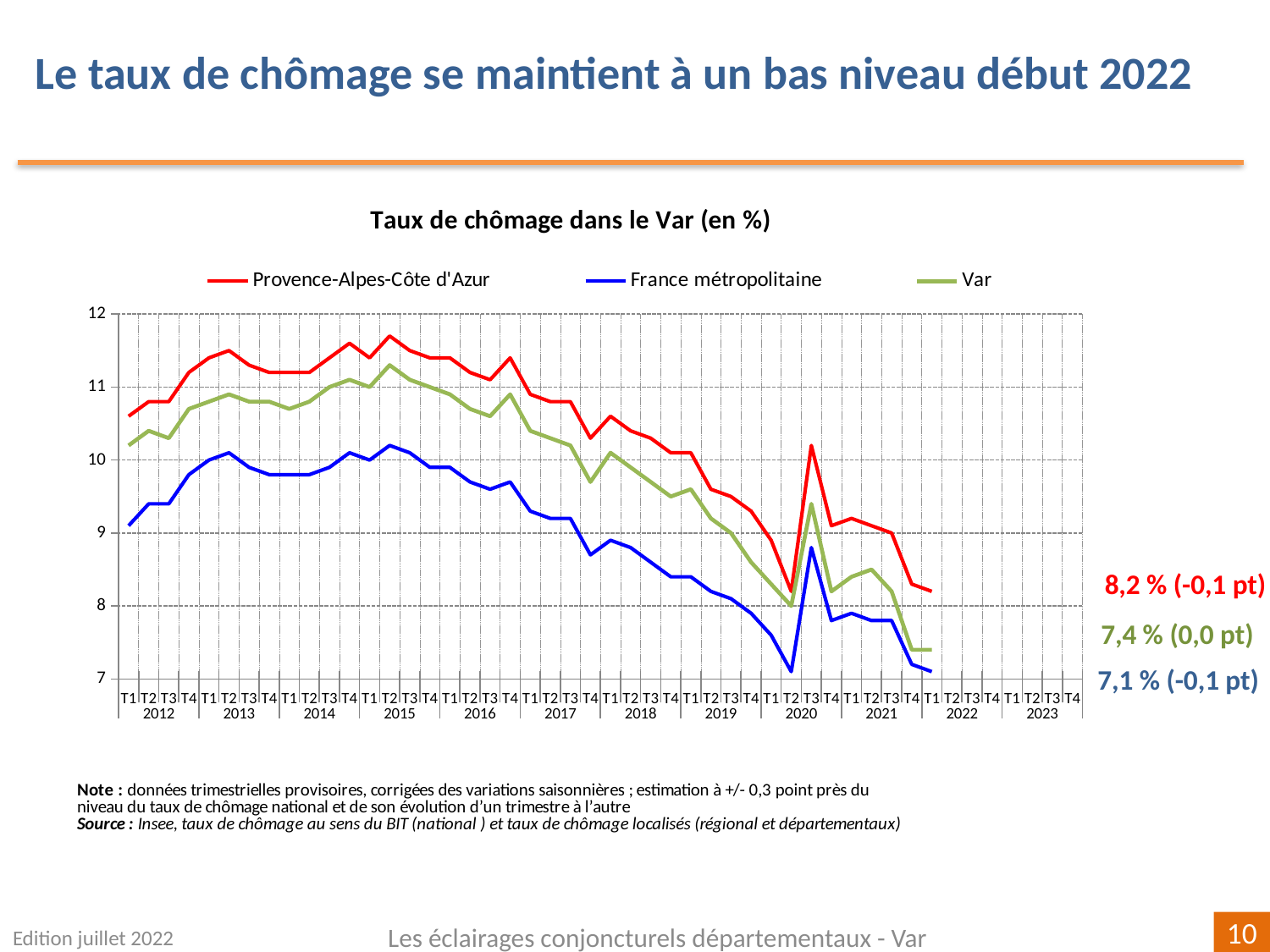
What is the latest unemployment rate shown for Provence-Alpes-Côte d'Azur? 8,2 % What is the title of the chart? Taux de chômage dans le Var (en %) What is the difference between the latest values for Provence-Alpes-Côte d'Azur and Var? 0,8 points Which series is higher at T1 2022, Provence-Alpes-Côte d'Azur or France métropolitaine? Provence-Alpes-Côte d'Azur Do the unemployment rates generally rise or fall between 2015 and 2019? fall Which series has the lowest value at the end of the period (T1 2022)? France métropolitaine What kind of chart is shown on the slide? line chart Is the value for Provence-Alpes-Côte d'Azur in T2 2015 greater or less than 11? greater What is the latest unemployment rate shown for Var? 7,4 % How many series does the legend list? 3 What is the latest unemployment rate shown for France métropolitaine? 7,1 % What is the quarterly change printed next to the latest Var value? 0,0 pt